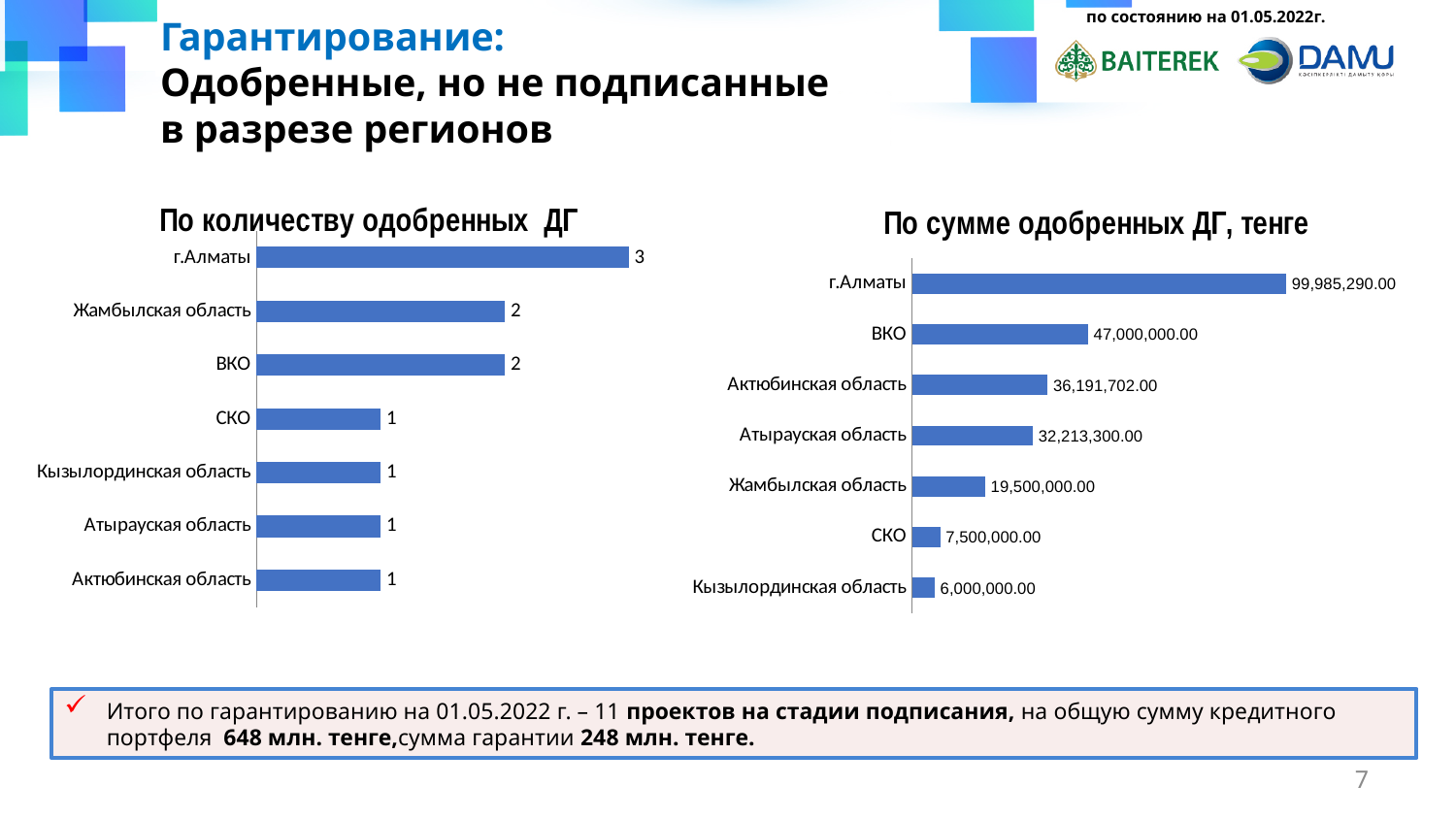
In the chart 'По количеству одобренных ДГ', what is the value for Жамбылская область? 2 In the chart 'По количеству одобренных ДГ', what is the value for г.Алматы? 3 In the chart 'По сумме одобренных ДГ, тенге', which category has the lowest value? Кызылординская область In the chart 'По сумме одобренных ДГ, тенге', what is the difference between СКО and Кызылординская область? 1,500,000.00 In the chart 'По сумме одобренных ДГ, тенге', which category has the highest value? г.Алматы In the chart 'По количеству одобренных ДГ', which category has the highest value? г.Алматы In the chart 'По сумме одобренных ДГ, тенге', which is larger: Актюбинская область or Жамбылская область? Актюбинская область In the chart 'По количеству одобренных ДГ', what is the difference between г.Алматы and СКО? 2 In the chart 'По сумме одобренных ДГ, тенге', what is the value for Атырауская область? 32,213,300.00 In the chart 'По количеству одобренных ДГ', how many categories are shown? 7 In the chart 'По сумме одобренных ДГ, тенге', what is the value for ВКО? 47,000,000.00 What type of chart is 'По сумме одобренных ДГ, тенге'? Bar chart